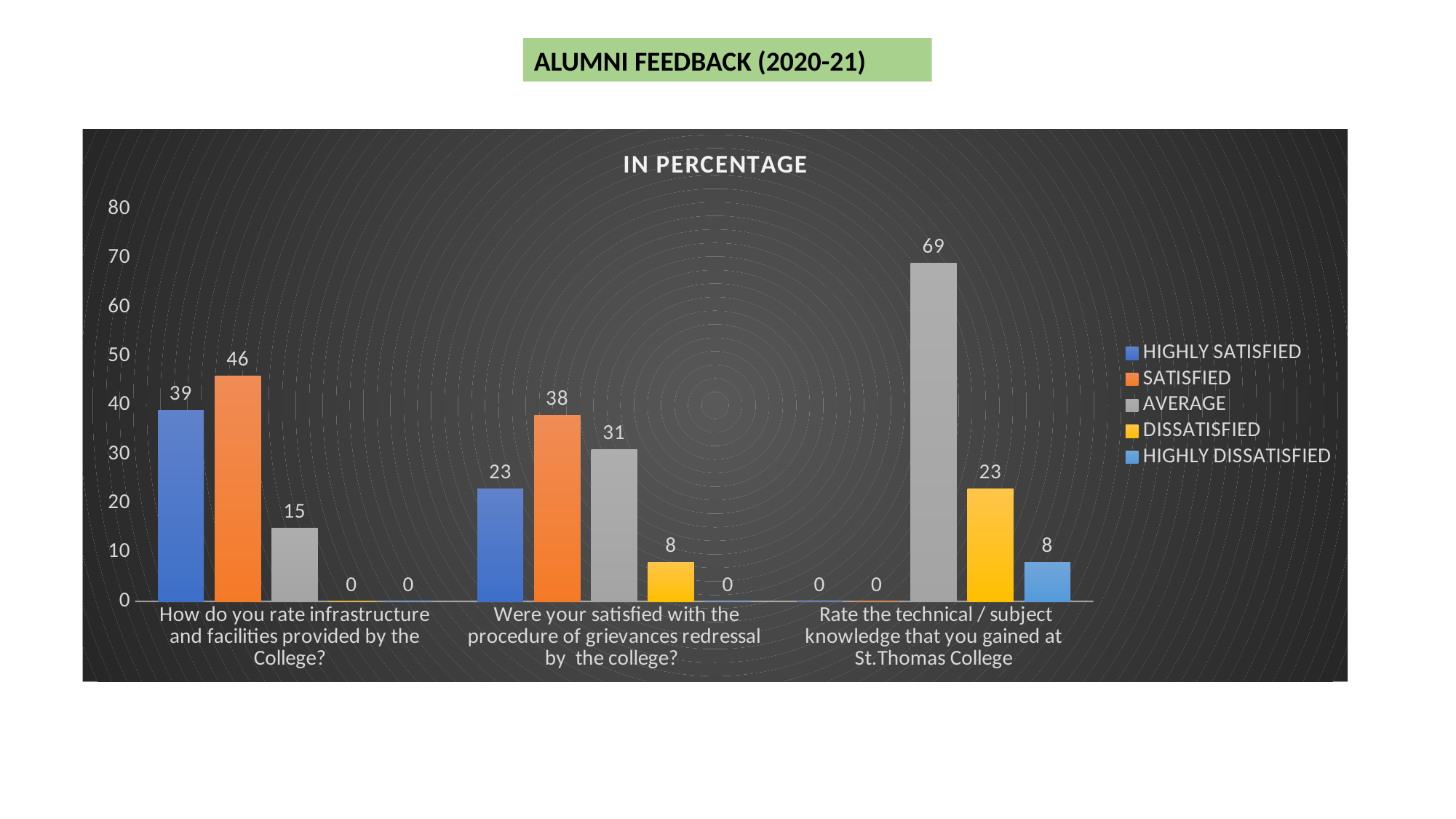
Which is larger for 'Were your satisfied with the procedure of grievances redressal by the college?': SATISFIED or AVERAGE? SATISFIED What is the HIGHLY SATISFIED value for 'Were your satisfied with the procedure of grievances redressal by the college?' 23 How many question categories are shown on the x axis? 3 What is the DISSATISFIED value for 'Were your satisfied with the procedure of grievances redressal by the college?' 8 Which series has the highest value for 'Rate the technical / subject knowledge that you gained at St.Thomas College'? AVERAGE What is the difference between the SATISFIED and HIGHLY SATISFIED values for 'How do you rate infrastructure and facilities provided by the College?' 7 What is the AVERAGE value for 'Rate the technical / subject knowledge that you gained at St.Thomas College'? 69 What kind of chart is shown on the slide? Bar chart What is the SATISFIED value for 'How do you rate infrastructure and facilities provided by the College?' 46 How many series does the legend list? 5 Which series has the highest value for 'How do you rate infrastructure and facilities provided by the College?' SATISFIED What is the title of the chart? IN PERCENTAGE